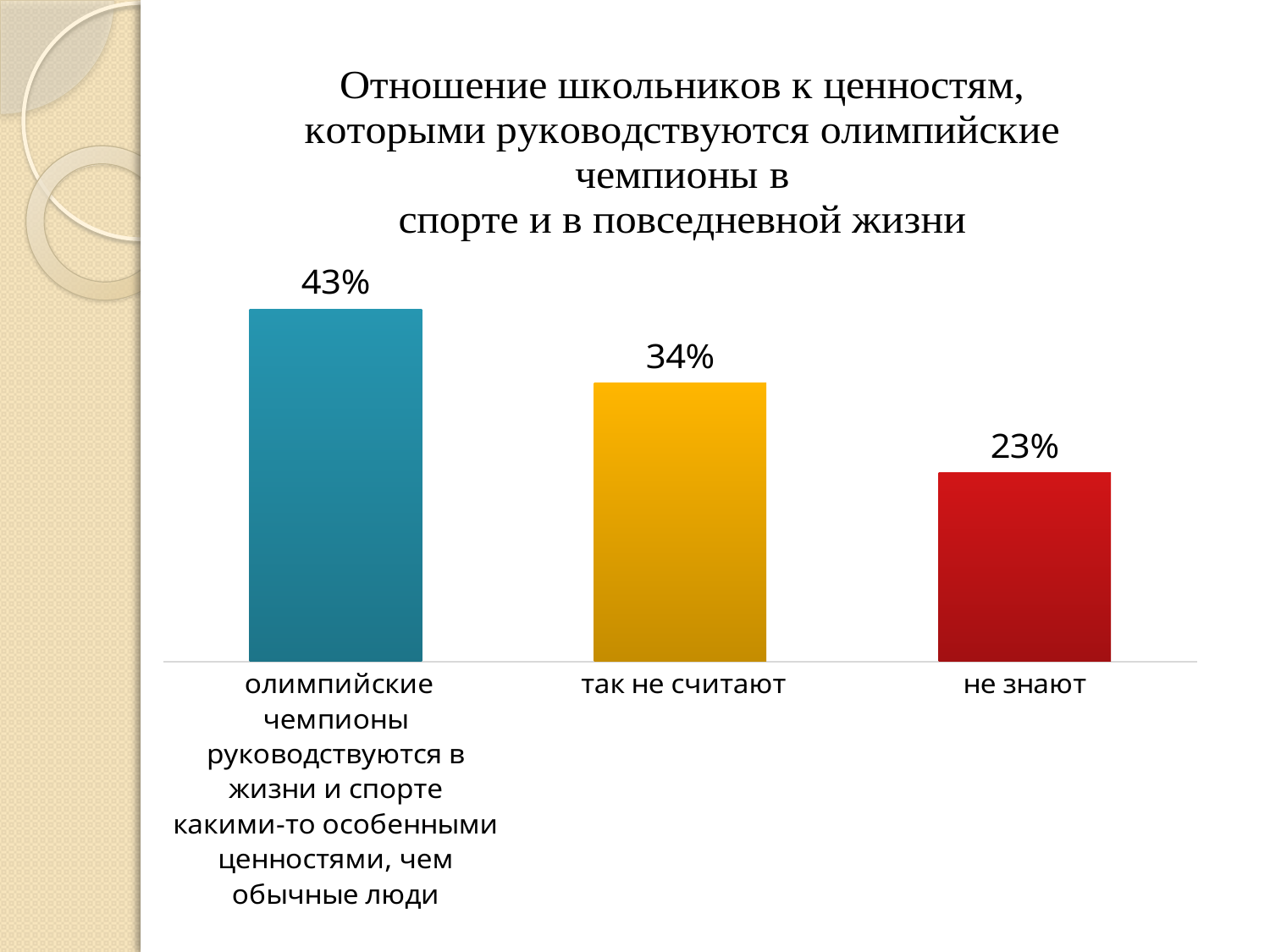
What is the difference between the highest and lowest values on the chart? 20% What is the difference between the "так не считают" value and the "не знают" value? 11% Do the values rise or fall from left to right across the categories? fall What colour is the bar for "не знают"? red What type of chart is shown on the slide? bar chart Which is larger: the value for "так не считают" or the value for "не знают"? так не считают Which category has the highest value? олимпийские чемпионы руководствуются в жизни и спорте какими-то особенными ценностями, чем обычные люди Which category has the lowest value? не знают What is the value shown for the "не знают" category? 23% How many categories are shown on the chart? 3 What percentage believe that Olympic champions are guided by special values in life and sport (the first bar)? 43% What percentage of schoolchildren answered "так не считают"? 34%